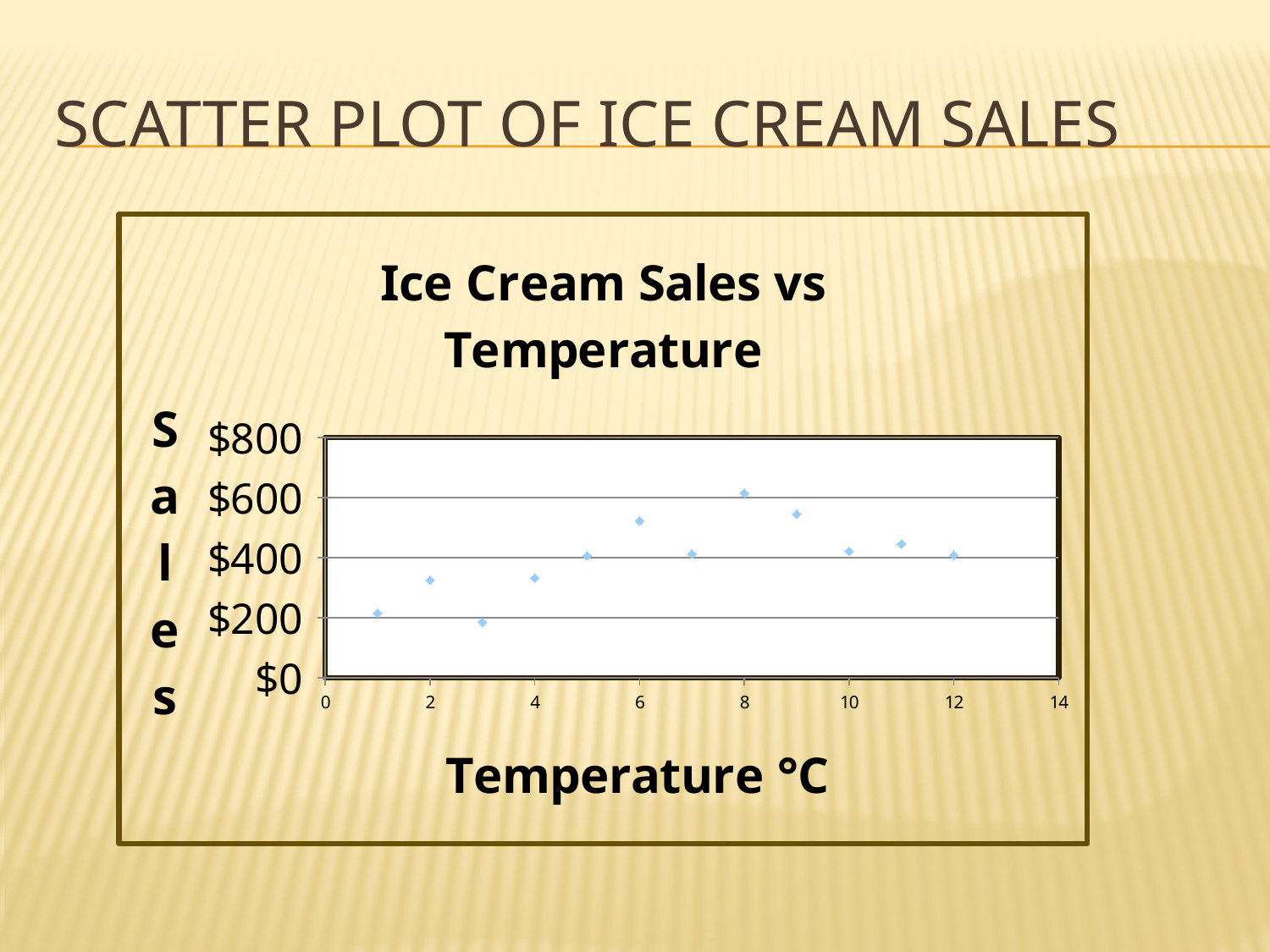
How many data points are plotted on the chart? 12 Do sales generally rise or fall as temperature increases along the x axis? Rise Is the sales value at temperature 2 greater or less than $400? less Which has the larger sales value, temperature 8 or temperature 10? Temperature 8 What is the title of the chart? Ice Cream Sales vs Temperature Is the sales value at temperature 6 greater or less than $400? greater Which temperature has the highest sales value on the chart? 8 What is the label on the x axis of the chart? Temperature °C Is the sales value at temperature 1 greater or less than $400? less What kind of chart is shown on the slide? Scatter plot Which has the larger sales value, temperature 6 or temperature 2? Temperature 6